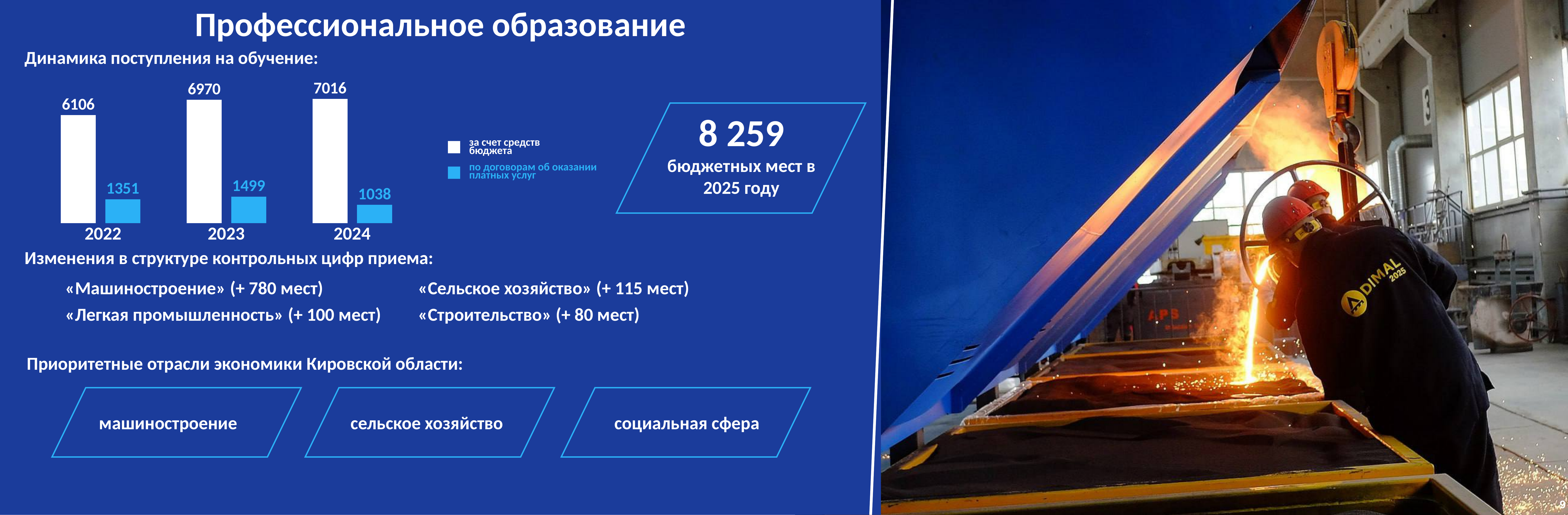
What is the value for 'по договорам об оказании платных услуг' in 2023? 1499 What is the value for 'по договорам об оказании платных услуг' in 2024? 1038 In which year is the 'по договорам об оказании платных услуг' value lowest? 2024 How many series does the chart legend list? 2 Which is larger: the 'по договорам об оказании платных услуг' value in 2022 or in 2023? 2023 In which year is the 'за счет средств бюджета' value highest? 2024 How many years are shown on the x axis of the chart? 3 What kind of chart is shown under 'Динамика поступления на обучение'? bar chart What is the value for 'за счет средств бюджета' in 2022? 6106 What is the difference between the 'за счет средств бюджета' values for 2023 and 2022? 864 Does the 'за счет средств бюджета' series rise or fall from 2022 to 2024? rise What is the difference between the 'по договорам об оказании платных услуг' values for 2023 and 2024? 461